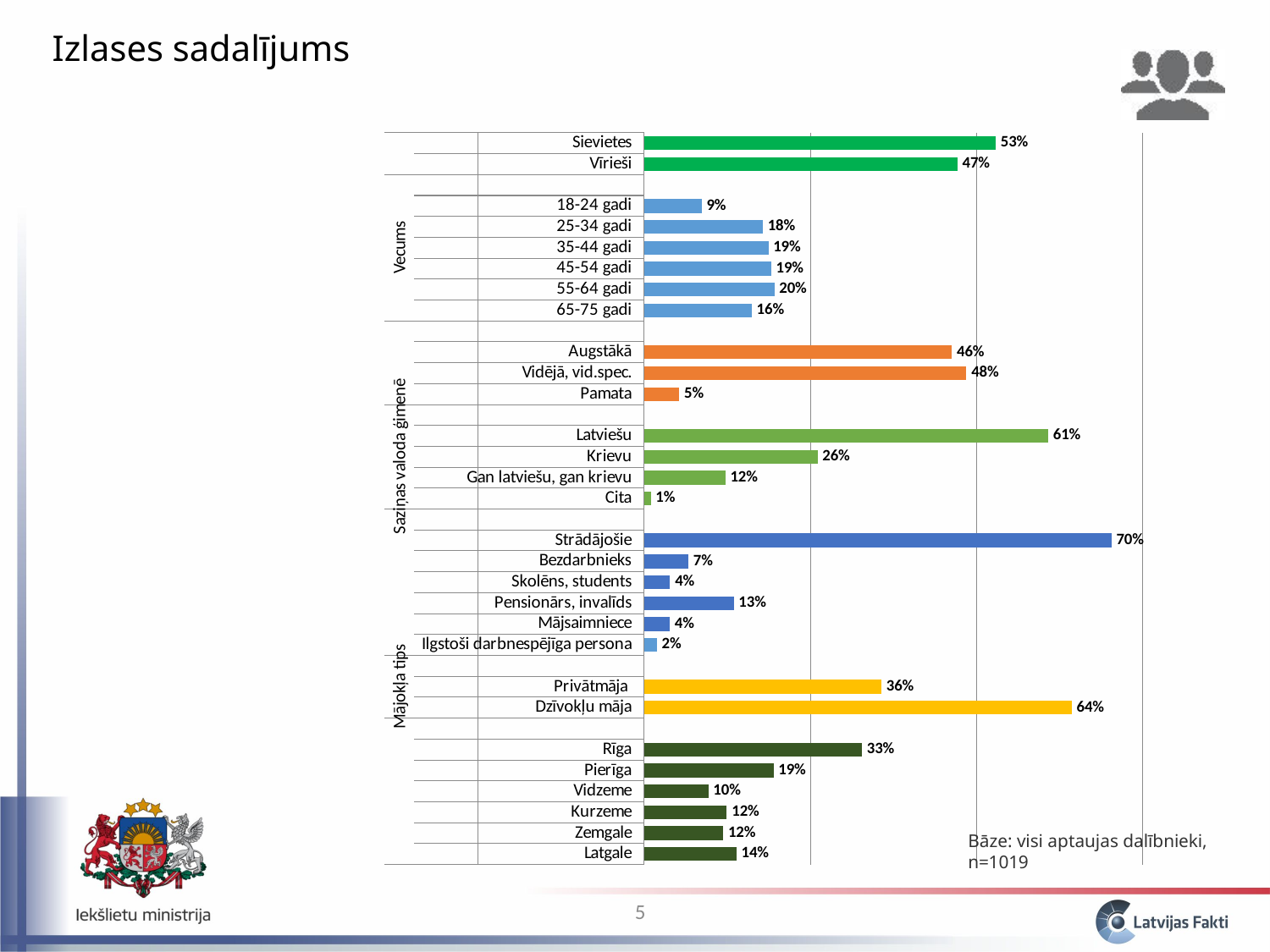
What value is shown for "Dzīvokļu māja"? 64% What is the title of the slide containing the chart? Izlases sadalījums What is the difference between the values for "Sievietes" and "Vīrieši"? 6% Which is larger, the value for "Augstākā" or for "Vidējā, vid.spec."? Vidējā, vid.spec. What type of chart is shown on the slide? Bar chart Which age group (gadi) has the lowest value? 18-24 gadi Which age group (gadi) has the highest value? 55-64 gadi How many age groups (gadi) are shown in the chart? 6 What is the difference between the values for "Latviešu" and "Krievu"? 35% Which region among Rīga, Pierīga, Vidzeme, Kurzeme, Zemgale and Latgale has the highest value? Rīga What value is shown for "Strādājošie"? 70% What percentage of the sample is shown for "Sievietes"? 53%